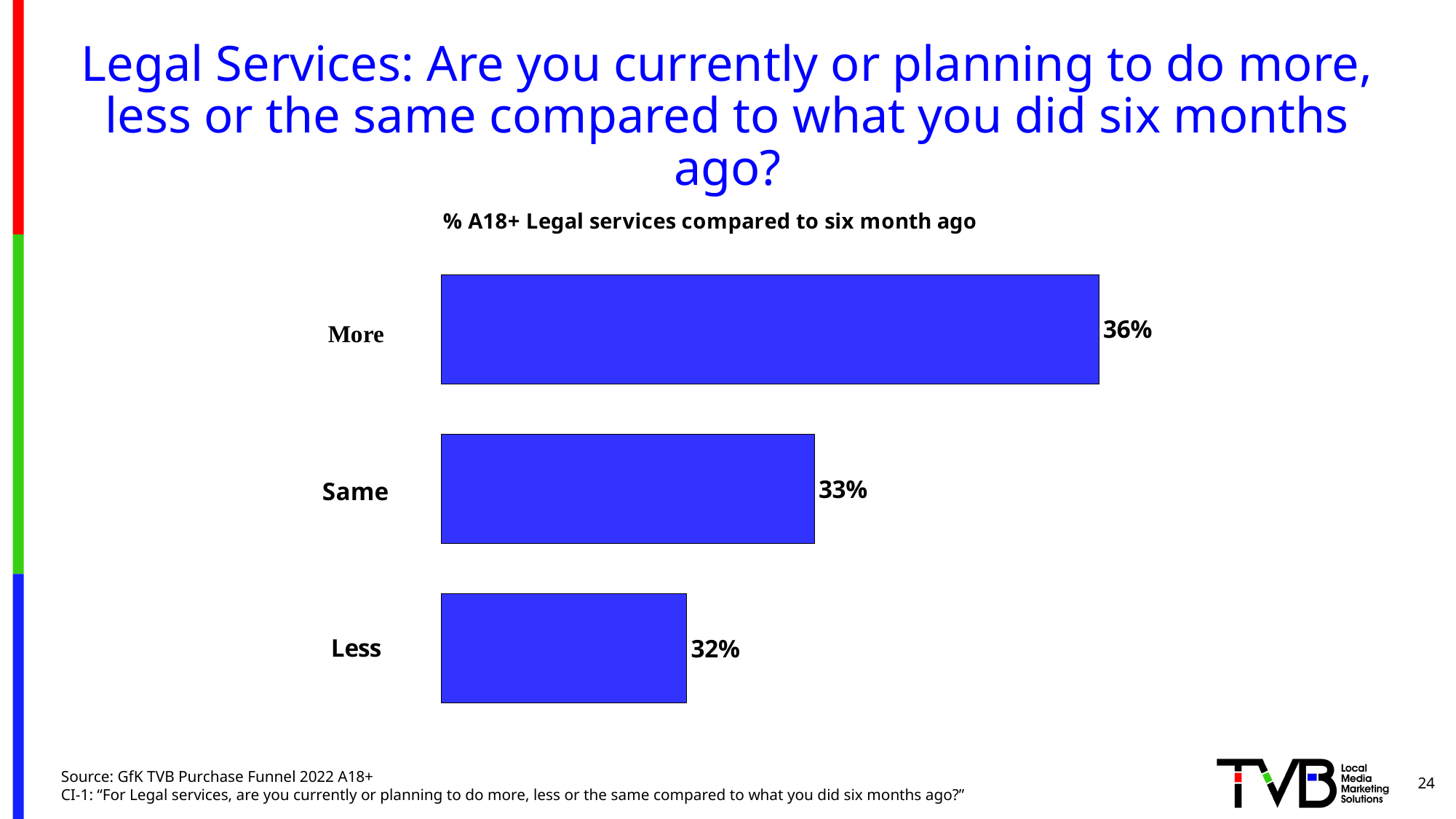
How many categories are shown in the chart? 3 What is the value shown for the "Same" category? 33% What is the difference in percentage points between the "Same" and "Less" categories? 1 percentage point What kind of chart is shown on the slide? Bar chart Which category has the lowest value in the chart? Less What is the difference in percentage points between the "More" and "Less" categories? 4 percentage points What percentage of A18+ respondents said they are doing or planning to do more legal services compared to six months ago? 36% What is the value shown for the "Less" category? 32% Which is larger, the value for "More" or the value for "Same"? More What is the title of the chart? % A18+ Legal services compared to six month ago What colour are the bars in the chart? Blue Which category has the highest value in the chart? More